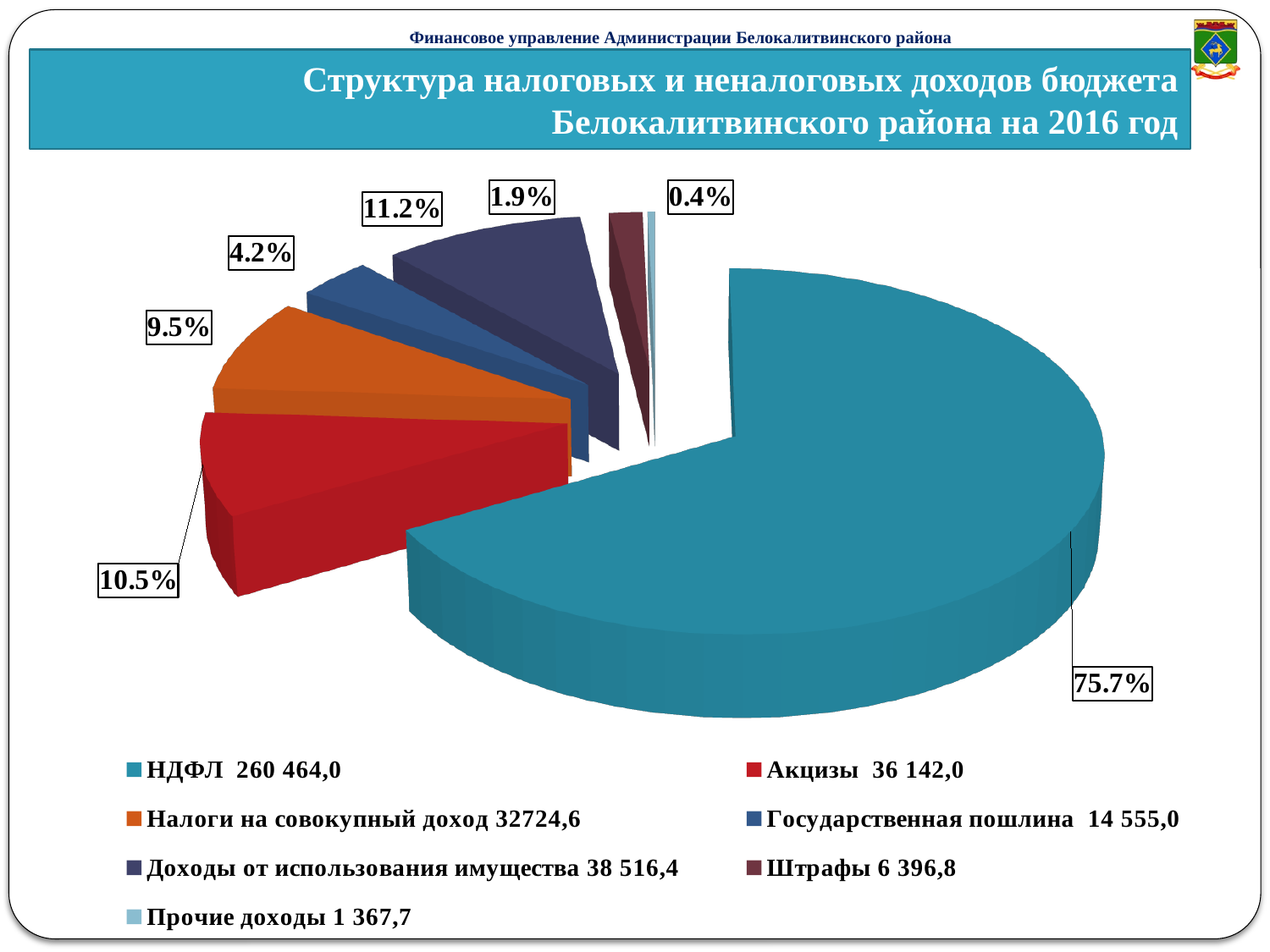
What value is shown in the legend for Штрафы? 6 396,8 What type of chart is shown on the slide? pie chart What share of the pie does Прочие доходы represent? 0.4% Which category has the largest share of the pie? НДФЛ What share of the pie does НДФЛ represent? 75.7% What is the difference in percentage points between the share for Доходы от использования имущества and the share for Государственная пошлина? 7.0% How many slices does the pie chart have? 7 What value is shown in the legend for Государственная пошлина? 14 555,0 What share of the pie does Акцизы represent? 10.5% Which category has the smallest share of the pie? Прочие доходы Which is larger: the share for Акцизы or the share for Налоги на совокупный доход? Акцизы